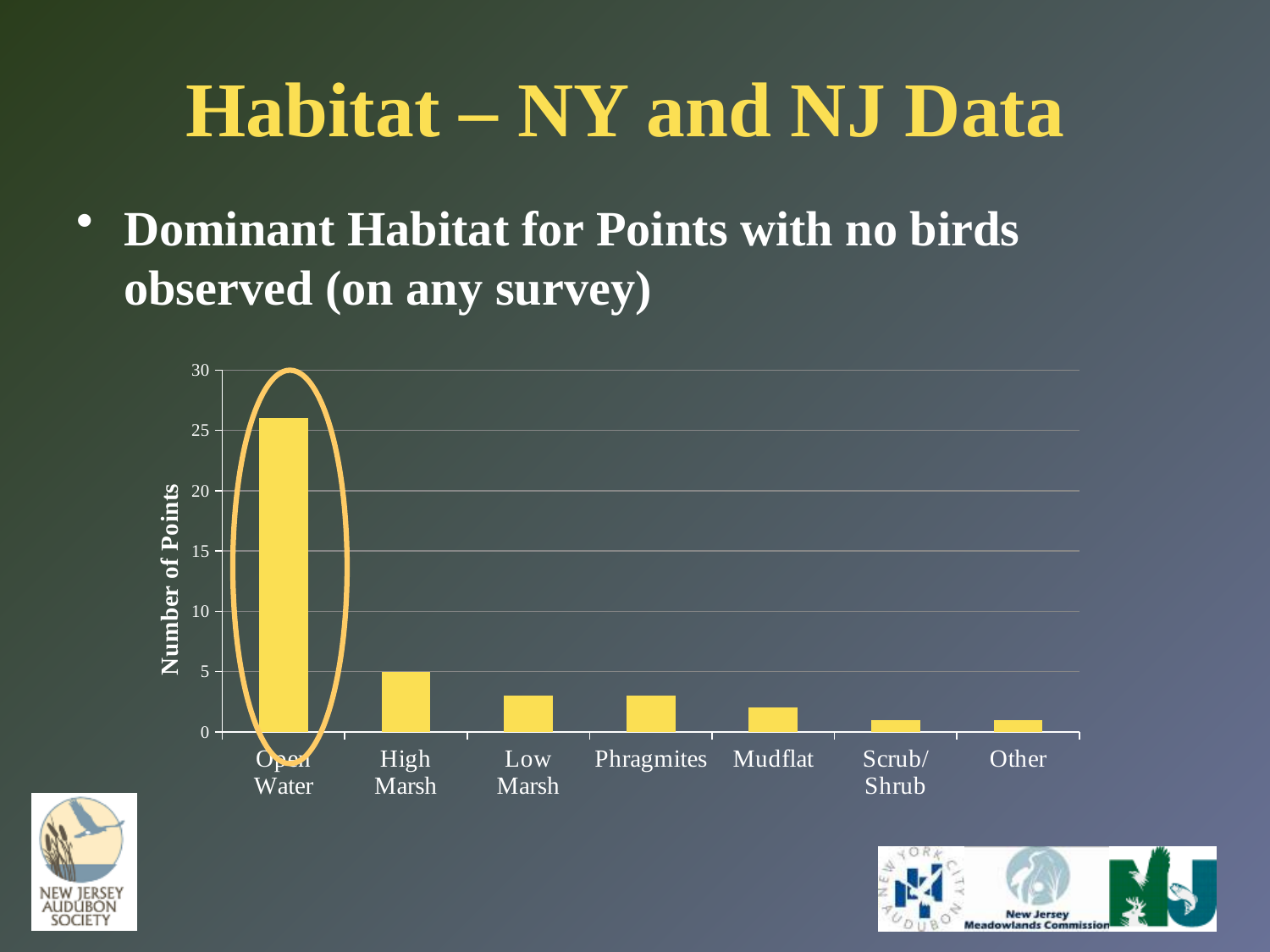
Is the value for Mudflat greater or less than 5? less Which has more points, High Marsh or Mudflat? High Marsh Which bar on the chart is circled? Open Water What is the label on the y axis of the chart? Number of Points Which has more points, Open Water or High Marsh? Open Water Which habitat category has the highest number of points? Open Water What kind of chart is shown on the slide? bar chart How many habitat categories are shown on the x axis of the chart? 7 Is the value for Open Water greater or less than 30? less Is the value for Low Marsh greater or less than 5? less What is the number of points for High Marsh? 5